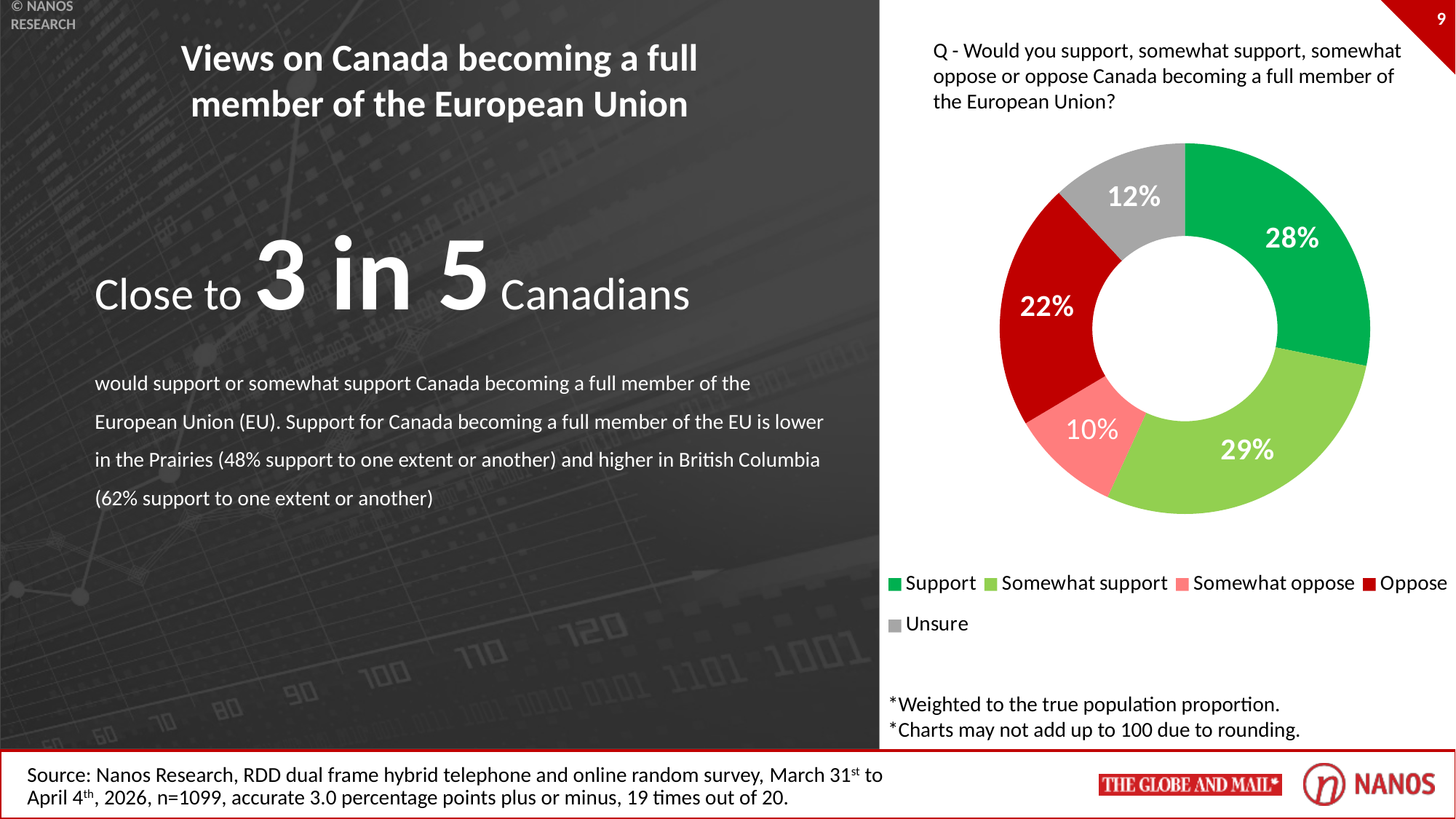
What percentage of respondents said they would support Canada becoming a full member of the European Union? 28% Which is larger, the share for Oppose or the share for Unsure? Oppose What percentage of respondents said they would somewhat support Canada becoming a full member of the EU? 29% What type of chart is used on this slide? Donut (pie) chart What is the difference in percentage points between Oppose and Somewhat oppose? 12 What percentage of respondents said they would oppose Canada becoming a full member of the EU? 22% What is the combined percentage of respondents who said Oppose or Somewhat oppose? 32% What is the combined percentage of respondents who said Support or Somewhat support? 57% What colour represents the Unsure category in the chart? Grey What percentage of respondents were unsure? 12% Which response category has the smallest share of the chart? Somewhat oppose How many response categories are shown in the chart? 5